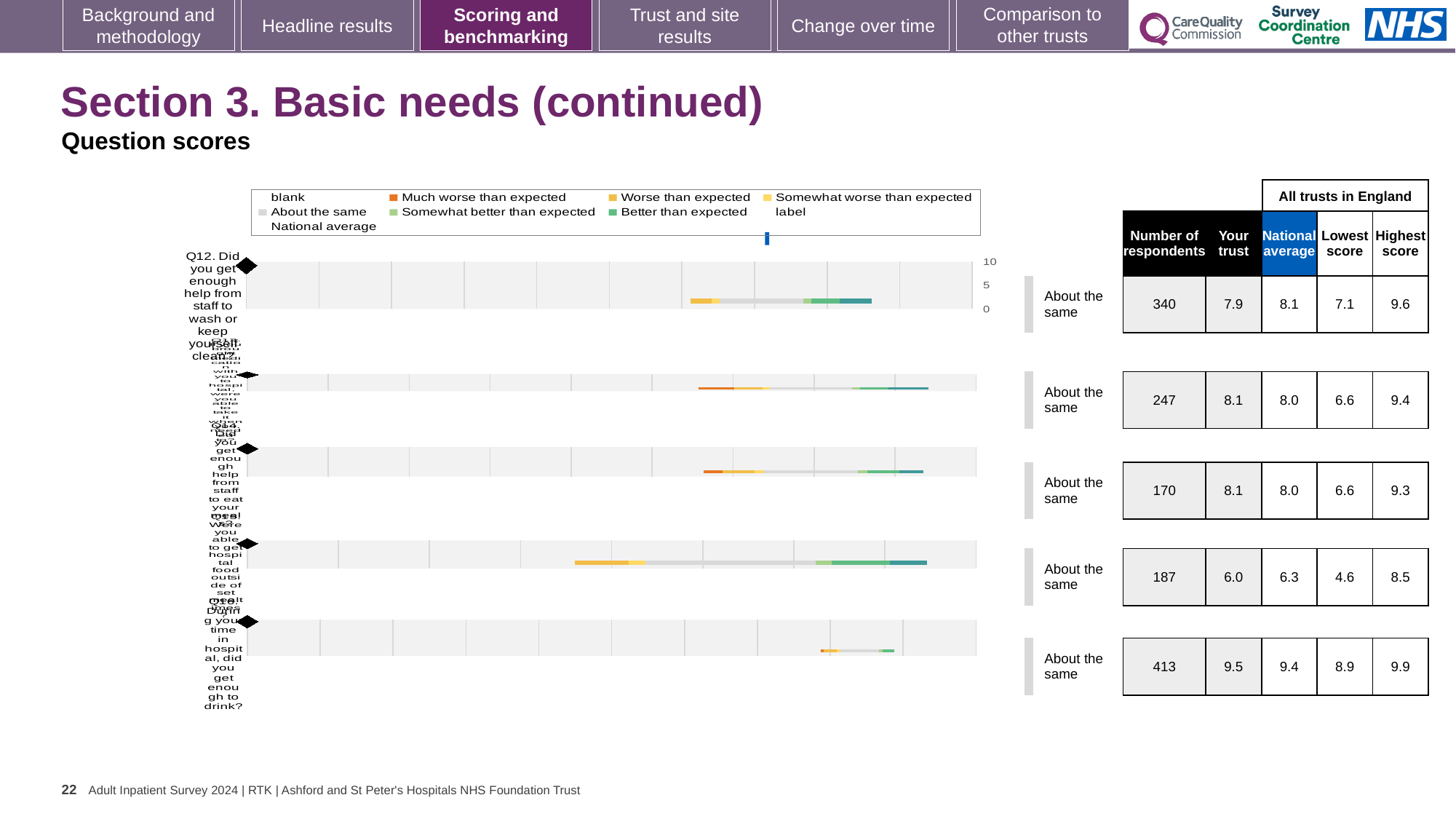
How many respondents answered Q12 (Did you get enough help from staff to wash or keep yourself clean?)? 340 What is the lowest score among all trusts in England for the bottom question row? 8.9 For Q12, which is larger: the 'Your trust' score or the national average? National average What is the 'Your trust' score for Q12? 7.9 For Q12, what is the difference between the national average and the 'Your trust' score? 0.2 Which question row has the highest 'Your trust' score? The fifth (bottom) row, 9.5 What is the national average score for Q12? 8.1 How many question rows are plotted on the chart? 5 How many respondents are listed for the third question row? 170 What benchmark category is shown for every question row on this slide? About the same Which question row has the lowest 'Your trust' score? The fourth row, 6.0 What is the highest score among all trusts in England for Q12? 9.6